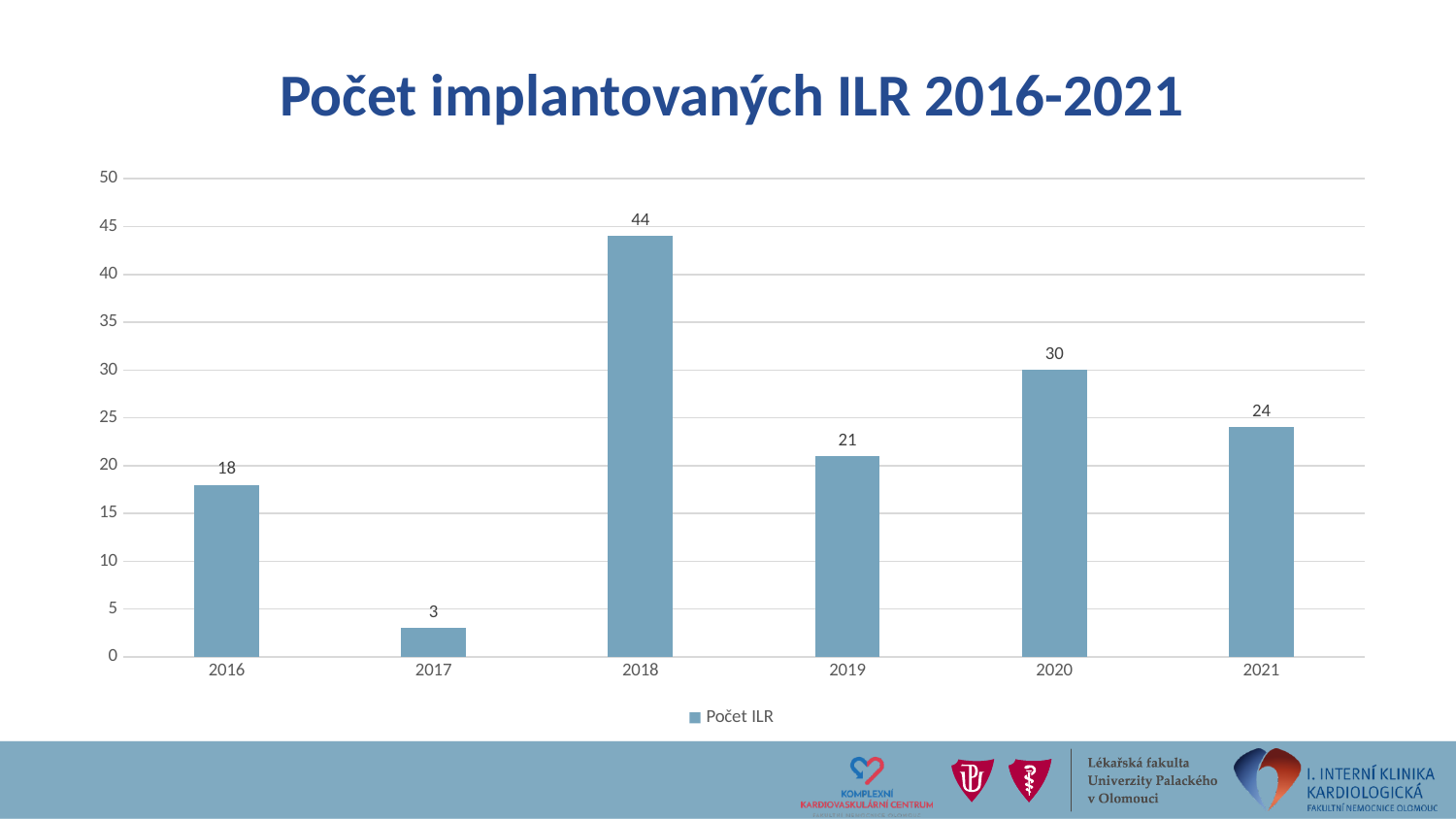
What is the difference between the values for 2018 and 2020? 14 What kind of chart is shown? bar chart What is the value for 2018? 44 Which is larger, the value for 2016 or the value for 2019? 2019 Which year has the highest value? 2018 What is the title of the chart? Počet implantovaných ILR 2016-2021 What is the value for 2021? 24 Which year has the lowest value? 2017 How many series does the legend list? 1 What is the value for 2017? 3 How many years are shown on the x axis? 6 Is the value for 2020 greater or less than 25? greater